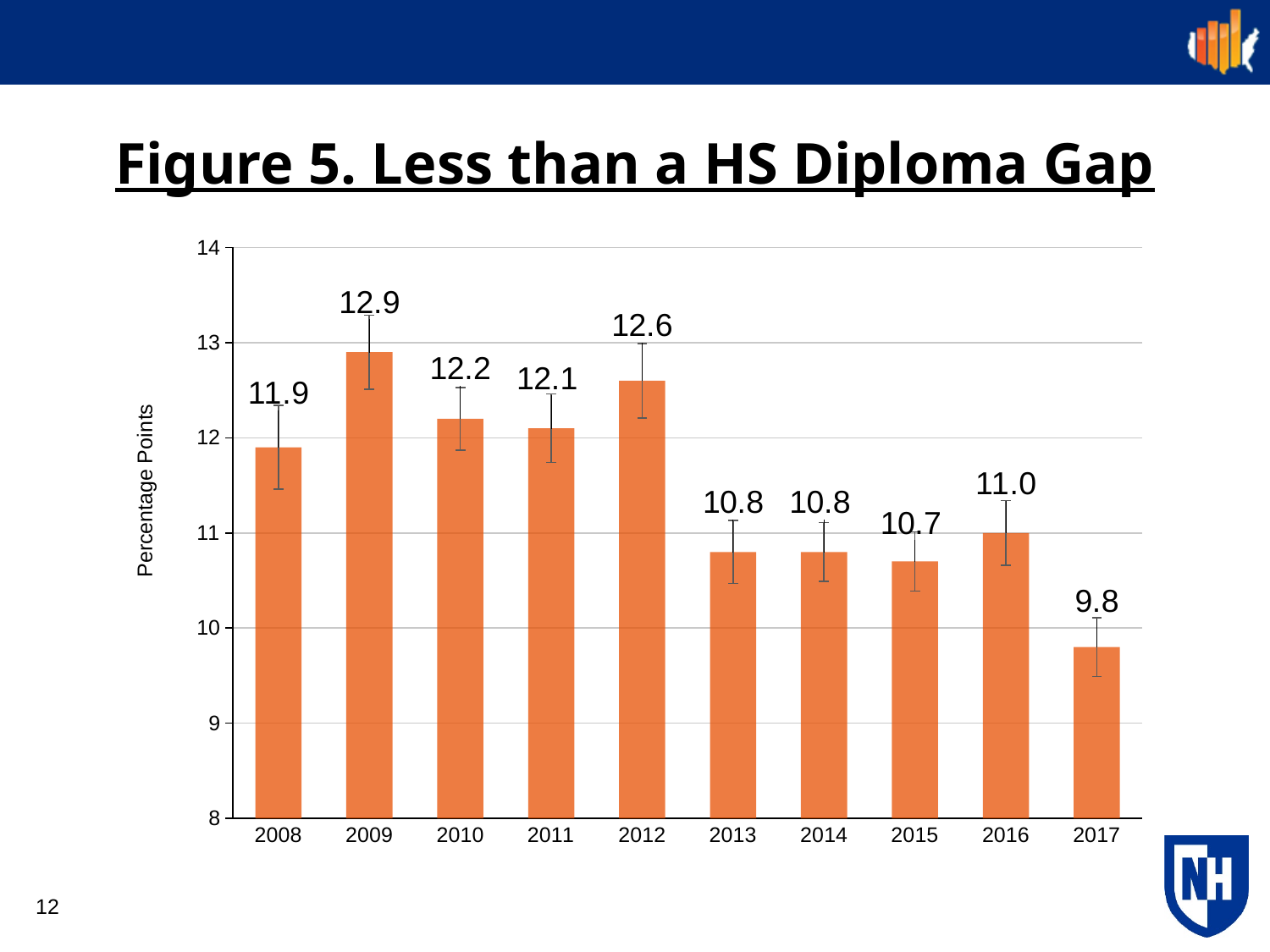
Which year has the lowest value? 2017 What is the value for 2009? 12.9 What kind of chart is shown? bar chart What is the difference between the values for 2012 and 2013? 1.8 What is the difference between the values for 2009 and 2017? 3.1 What is the value for 2017? 9.8 Is the value for 2012 greater or less than 12? greater How many years are shown on the x axis? 10 Which is larger, the value for 2008 or the value for 2016? 2008 Which year has the highest value? 2009 What is the label of the y axis? Percentage Points What is the value for 2015? 10.7